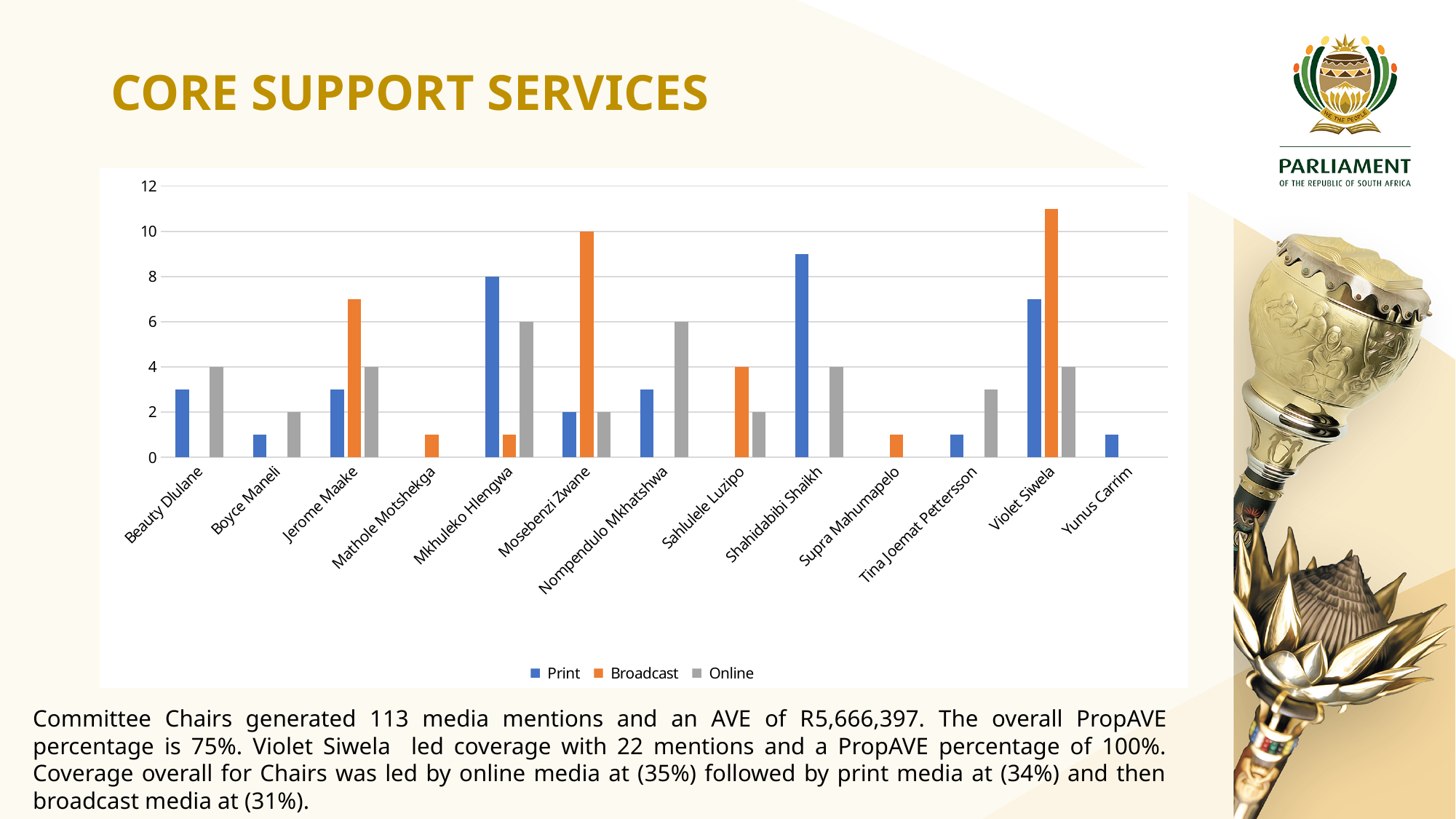
Is the Print value for Shahidabibi Shaikh greater or less than 8? greater What is the Online value for Nompendulo Mkhatshwa? 6 What is the Online value for Beauty Dlulane? 4 What is the Broadcast value for Mosebenzi Zwane? 10 What is the Print value for Mkhuleko Hlengwa? 8 What kind of chart is shown on the slide? bar chart Which series is shown in orange in the legend? Broadcast Which is larger: the Broadcast value for Mosebenzi Zwane or the Print value for Mkhuleko Hlengwa? Broadcast value for Mosebenzi Zwane What is the difference between the Broadcast and Print values for Mosebenzi Zwane? 8 How many committee chairs (categories) are shown on the x axis? 13 Is the Broadcast value for Violet Siwela greater or less than 10? greater How many series does the legend list? 3